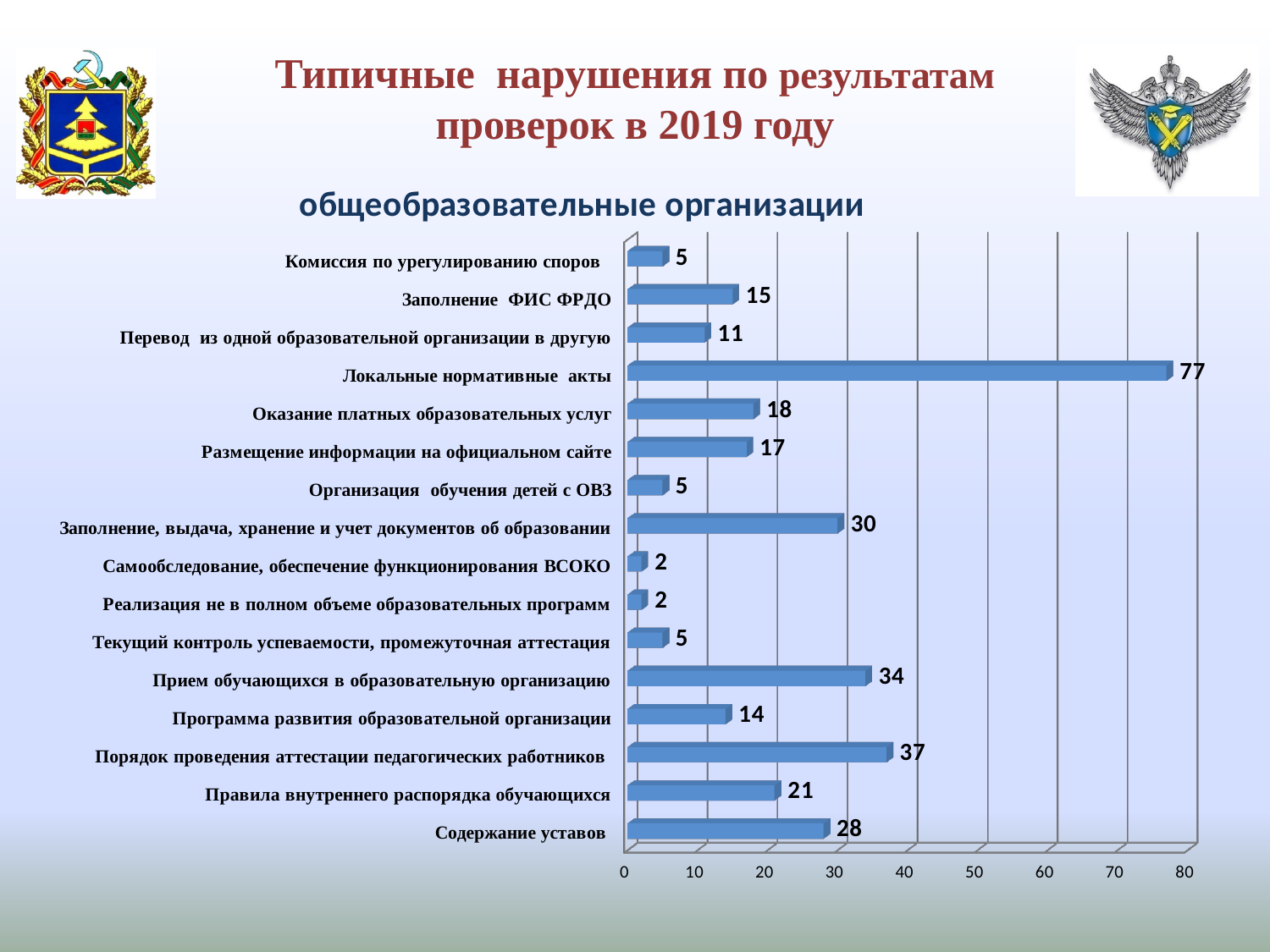
Which category has the highest value? Локальные нормативные акты What is the value for "Заполнение ФИС ФРДО"? 15 What is the lowest value shown on the chart? 2 What is the subtitle shown directly above the chart? общеобразовательные организации Is the value for "Правила внутреннего распорядка обучающихся" greater or less than 20? greater Which is larger: the value for "Оказание платных образовательных услуг" or the value for "Размещение информации на официальном сайте"? Оказание платных образовательных услуг What is the value for "Порядок проведения аттестации педагогических работников"? 37 What is the difference between the values for "Прием обучающихся в образовательную организацию" and "Содержание уставов"? 6 What is the value for "Содержание уставов"? 28 How many categories are shown on the chart? 16 What kind of chart is shown on the slide? bar chart What is the value for "Локальные нормативные акты"? 77